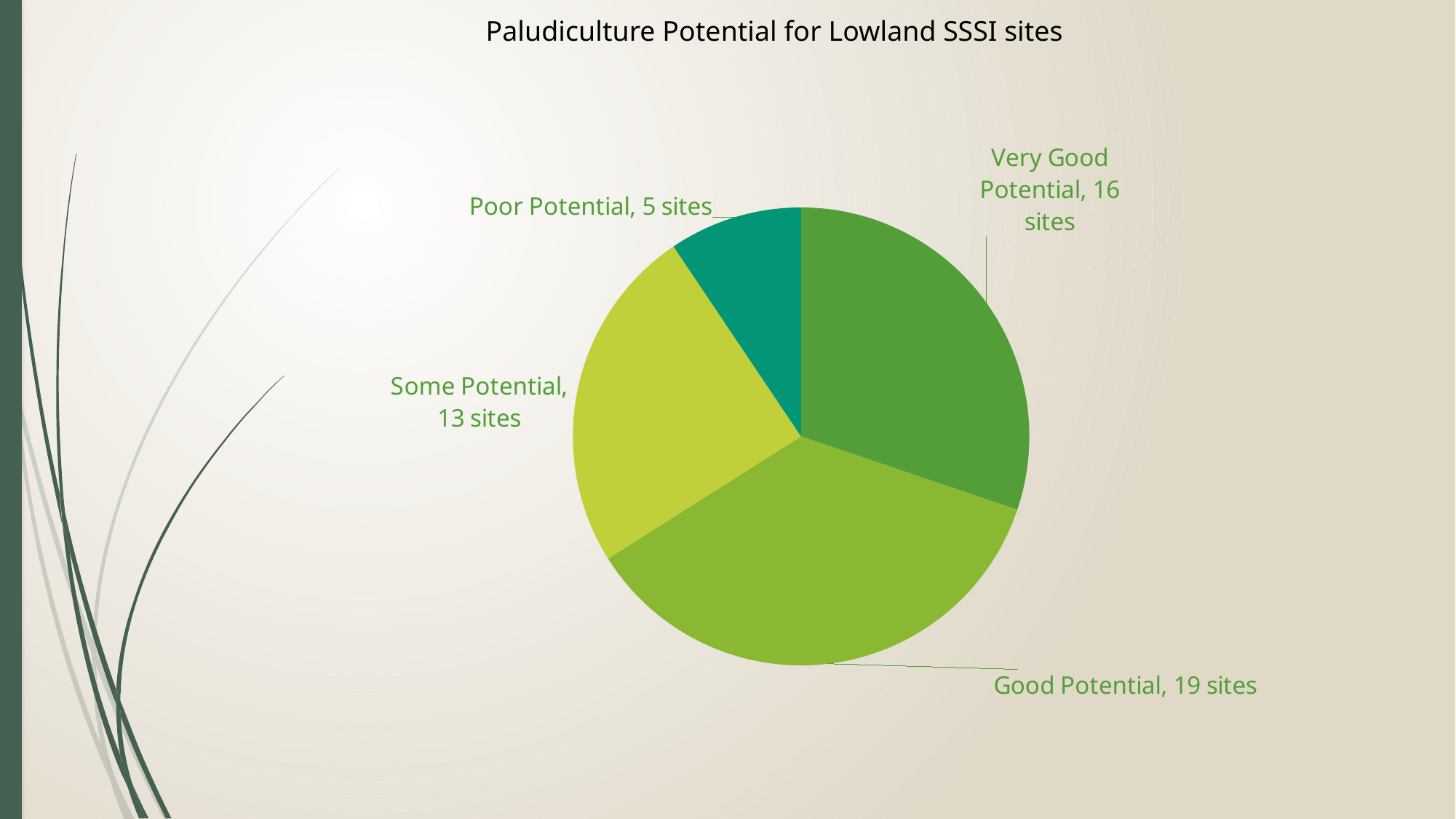
How many categories are shown in the pie chart? 4 What is the total number of sites across all categories in the pie chart? 53 sites What is the title of the chart? Paludiculture Potential for Lowland SSSI sites How many sites have Poor Potential? 5 sites Which has more sites, Some Potential or Poor Potential? Some Potential What is the difference in the number of sites between Good Potential and Very Good Potential? 3 sites How many sites have Some Potential? 13 sites Which category has the smallest slice of the pie? Poor Potential What type of chart is shown on the slide? pie chart How many sites have Very Good Potential? 16 sites How many sites have Good Potential? 19 sites Which category has the largest slice of the pie? Good Potential